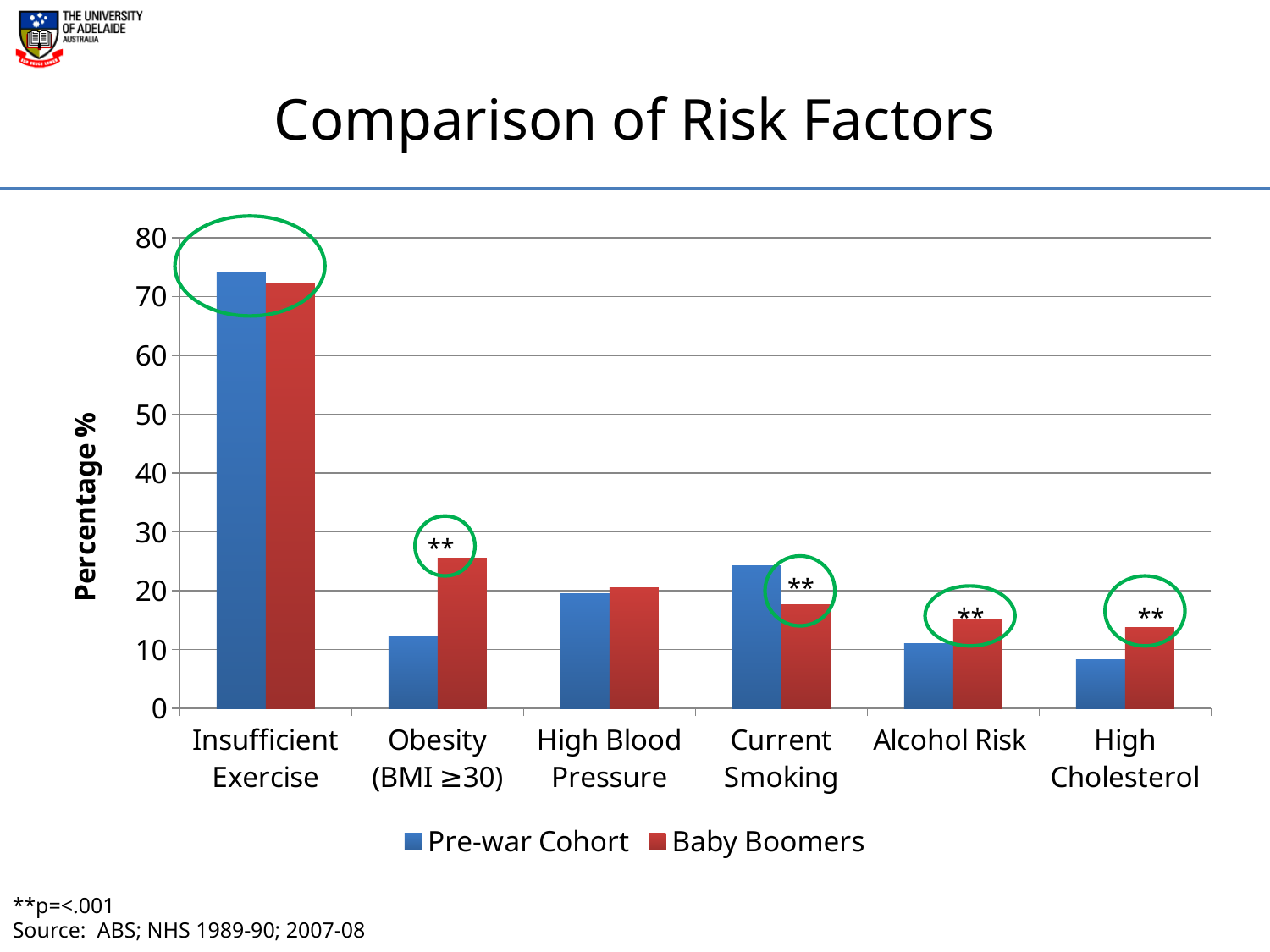
Is the Pre-war Cohort value for Insufficient Exercise greater or less than 70? greater What is the label of the y axis? Percentage % How many risk factor categories are shown on the x axis? 6 What kind of chart is shown on the slide? bar chart Which risk factor has the lowest value for the Pre-war Cohort? High Cholesterol Is the Pre-war Cohort value for High Cholesterol greater or less than 10? less Which risk factor has the highest value for the Pre-war Cohort? Insufficient Exercise For Current Smoking, which series has the larger value, Pre-war Cohort or Baby Boomers? Pre-war Cohort How many series does the legend list? 2 Is the Baby Boomers value for Obesity (BMI ≥30) greater or less than 20? greater For Obesity (BMI ≥30), which series has the larger value, Pre-war Cohort or Baby Boomers? Baby Boomers Which risk factor has the highest value for Baby Boomers? Insufficient Exercise